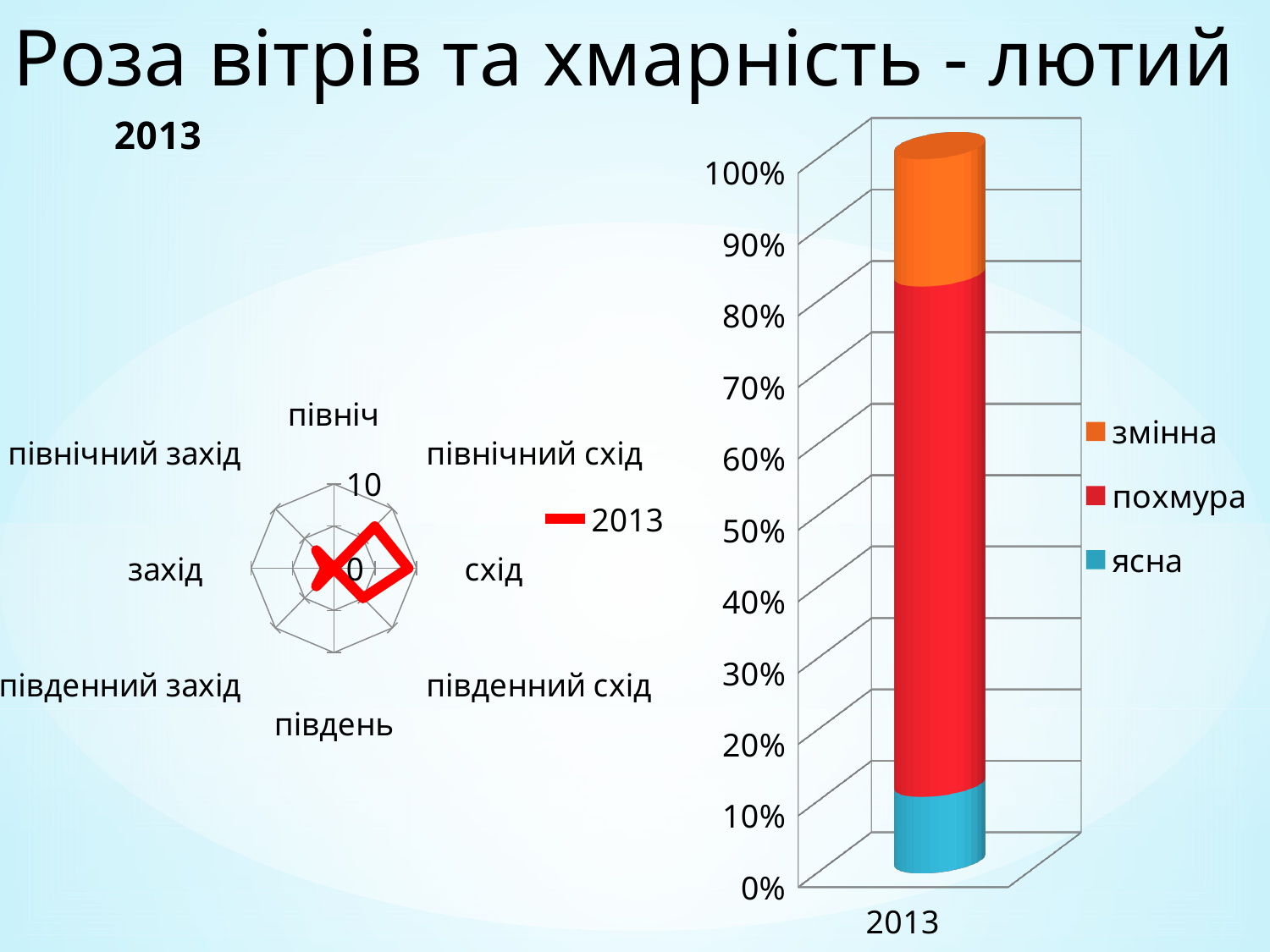
In the right-hand bar chart, which series takes up the largest part of the 2013 bar? похмура How many wind directions are shown on the left-hand radar chart? 8 In the right-hand bar chart, is the share for похмура in 2013 greater or less than 50%? greater What are the legend entries of the right-hand bar chart? змінна, похмура, ясна In the right-hand bar chart, is the share for ясна in 2013 greater or less than 20%? less How many series does the legend of the right-hand bar chart list? 3 In the right-hand bar chart, which is larger for 2013: похмура or ясна? похмура In the left-hand radar chart, which direction has the highest value? схід What kind of chart is the chart on the left side of the slide? radar chart What kind of chart is the chart on the right side of the slide? bar chart How many categories are shown on the x axis of the right-hand bar chart? 1 How many series does the legend of the left-hand radar chart list? 1